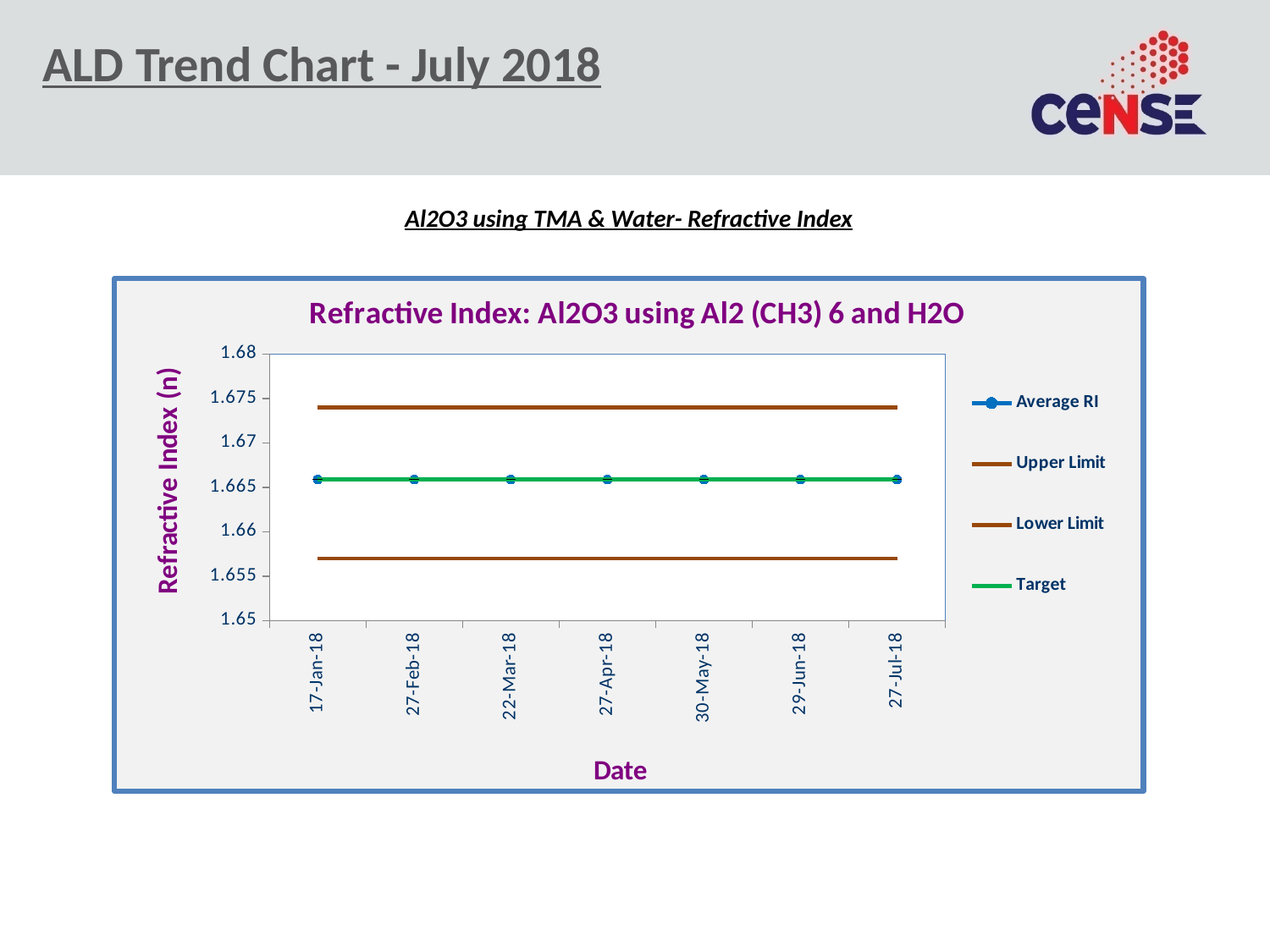
How many series does the chart legend list? 4 Does the Average RI series rise, fall, or stay flat from 17-Jan-18 to 27-Jul-18? stays flat Which series has the highest values on the chart? Upper Limit Is the Lower Limit value greater or less than 1.66? less How many dates are shown on the x axis of the chart? 7 What is the title of the chart? Refractive Index: Al2O3 using Al2 (CH3) 6 and H2O What is the label of the y axis of the chart? Refractive Index (n) Is the Average RI value on 27-Jul-18 greater or less than 1.67? less Which series has the lowest values on the chart? Lower Limit Is the Upper Limit value greater or less than 1.67? greater What kind of chart is shown on the slide? line chart